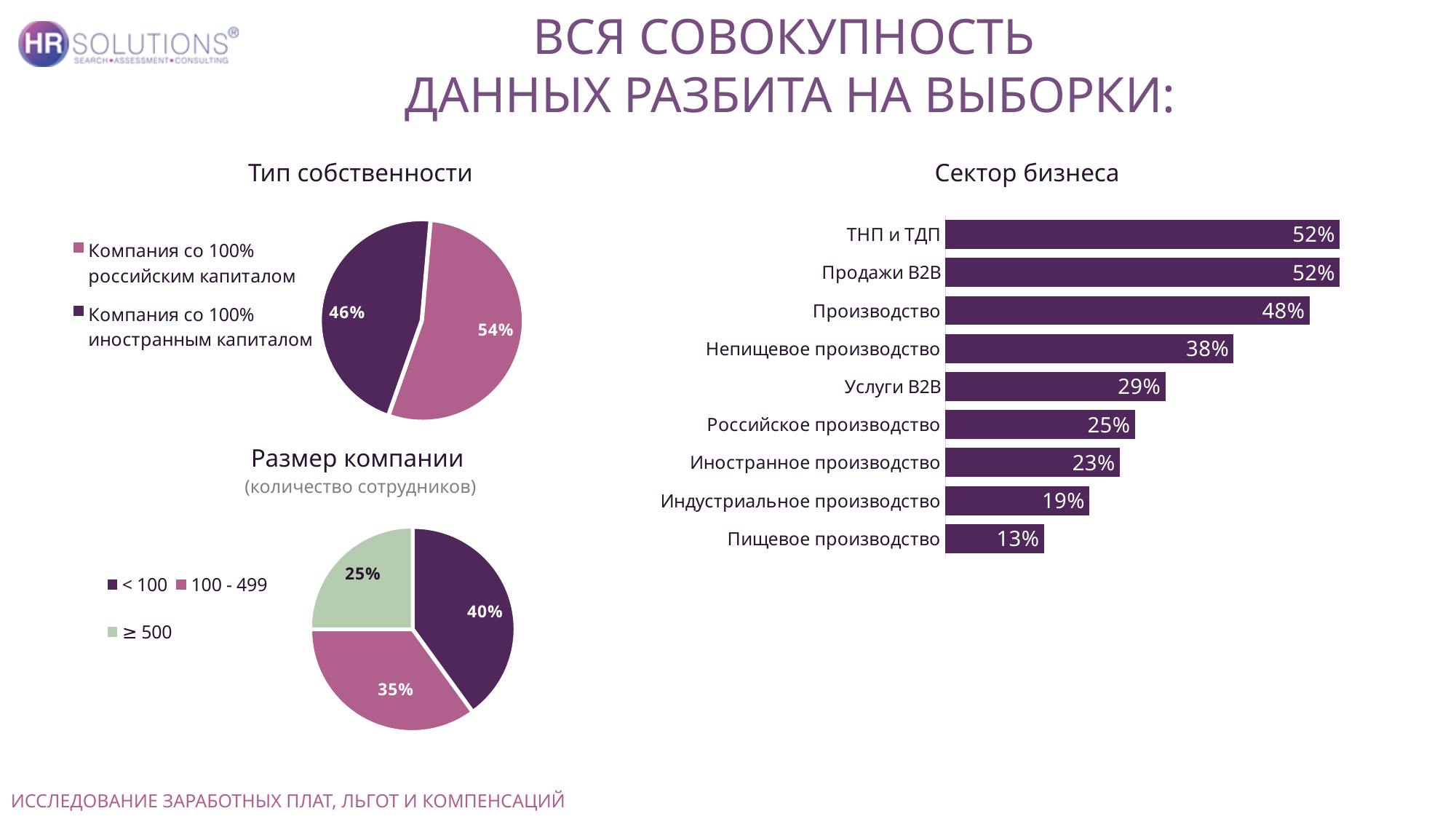
In the 'Сектор бизнеса' chart, what is the difference between 'Производство' and 'Услуги B2B'? 19% In the 'Сектор бизнеса' chart, how many categories are shown? 9 In the 'Тип собственности' chart, what share is 'Компания со 100% российским капиталом'? 54% What kind of chart is the 'Тип собственности' chart? Pie chart In the 'Тип собственности' chart, what share is 'Компания со 100% иностранным капиталом'? 46% What kind of chart is the 'Сектор бизнеса' chart? Bar chart In the 'Сектор бизнеса' chart, what is the value for 'Непищевое производство'? 38% How many categories does the legend of the 'Размер компании' chart list? 3 In the 'Размер компании' chart, what share is the '< 100' slice? 40% In the 'Сектор бизнеса' chart, which category has the lowest value? Пищевое производство In the 'Размер компании' chart, which category has the smallest slice? ≥ 500 In the 'Размер компании' chart, what is the difference between the '< 100' and '100 - 499' slices? 5%